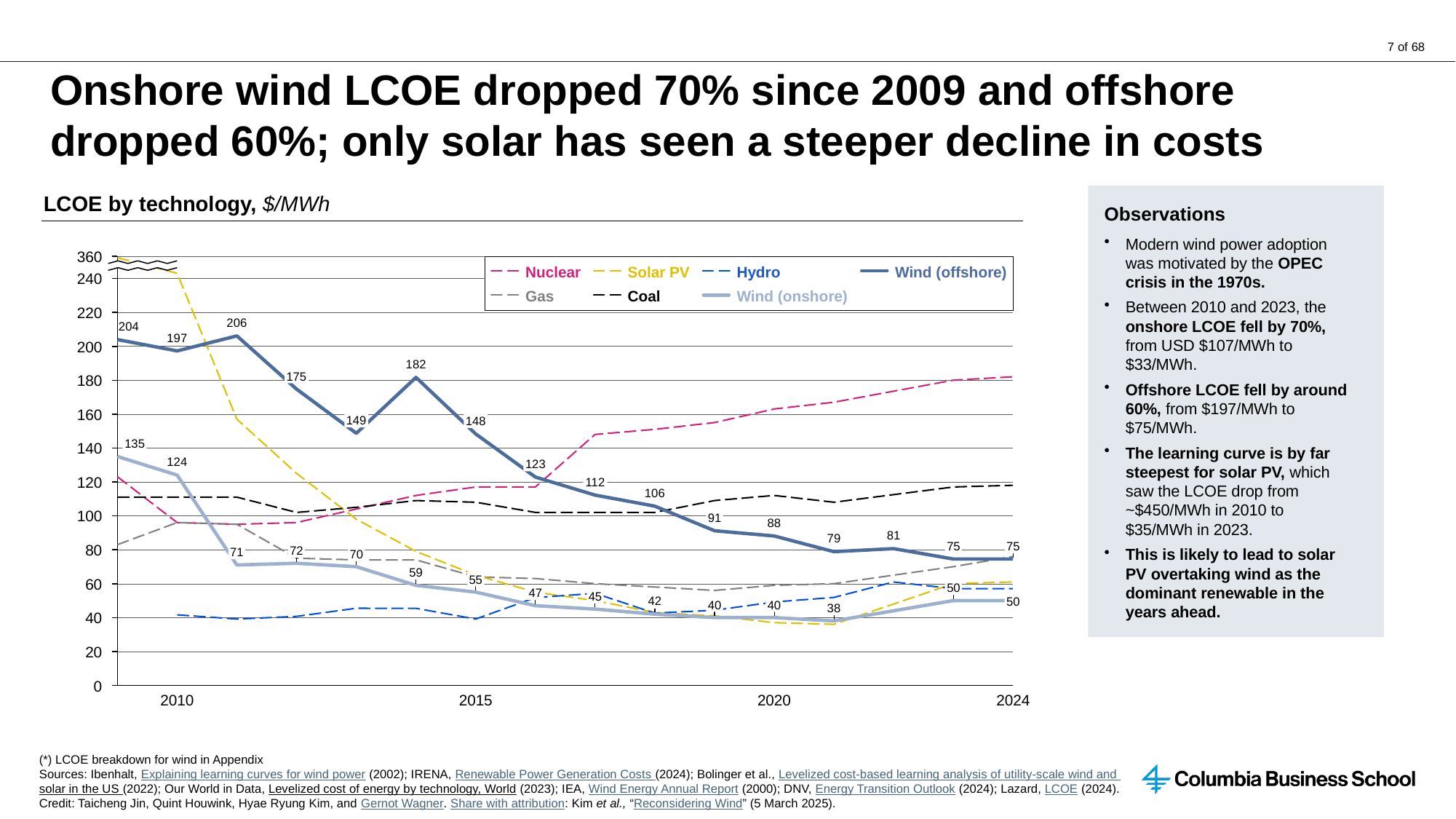
How many series does the legend list? 7 What is the difference between the Wind (offshore) values in 2009 and 2024? 129 Is the Nuclear value in 2024 greater or less than 160? greater What is the Wind (onshore) LCOE value in 2010? 124 What is the lowest labelled value of the Wind (onshore) series? 38 Does the Wind (offshore) series generally rise or fall from 2011 to 2024? Fall What is the Wind (offshore) LCOE value in 2024? 75 What is the Wind (offshore) LCOE value in 2014? 182 What kind of chart is shown on the slide? Line chart Which is larger, the Wind (offshore) value in 2013 or in 2014? 2014 What unit is given in the chart title? $/MWh In which year does the Wind (offshore) series reach its highest labelled value? 2011